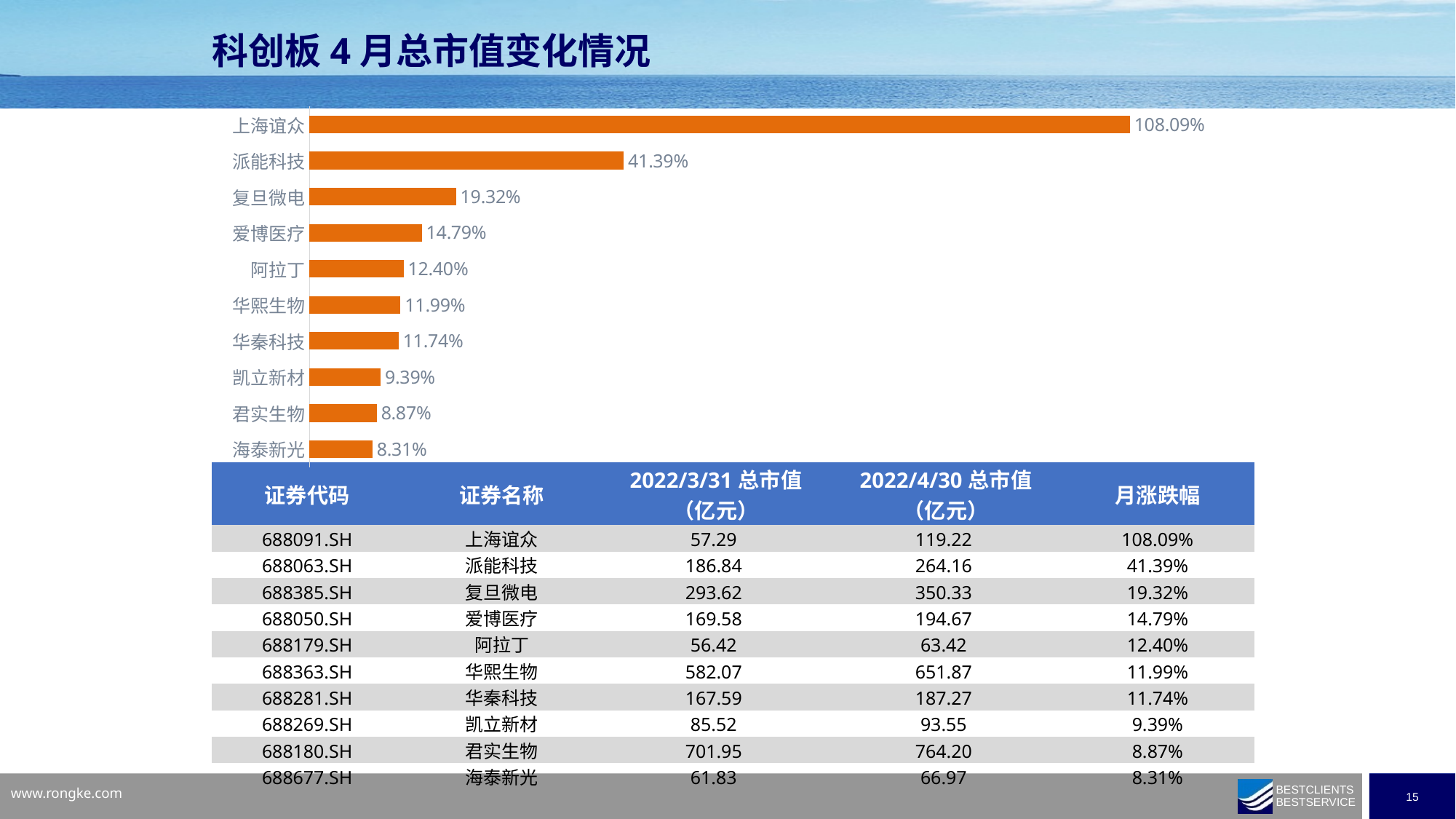
What kind of chart is shown on the slide? Bar chart How many categories are shown in the bar chart? 10 What is the value shown for 阿拉丁 in the bar chart? 12.40% What is the difference between the values for 上海谊众 and 派能科技 in the bar chart? 66.70 percentage points What is the value shown for 上海谊众 in the bar chart? 108.09% Which category has the lowest value in the bar chart? 海泰新光 Which category has the highest value in the bar chart? 上海谊众 What is the title of the slide containing the bar chart? 科创板 4 月总市值变化情况 What is the difference between the values for 复旦微电 and 爱博医疗 in the bar chart? 4.53 percentage points What is the value shown for 海泰新光 in the bar chart? 8.31% What is the value shown for 派能科技 in the bar chart? 41.39% Which has a larger value in the bar chart, 华熙生物 or 凯立新材? 华熙生物